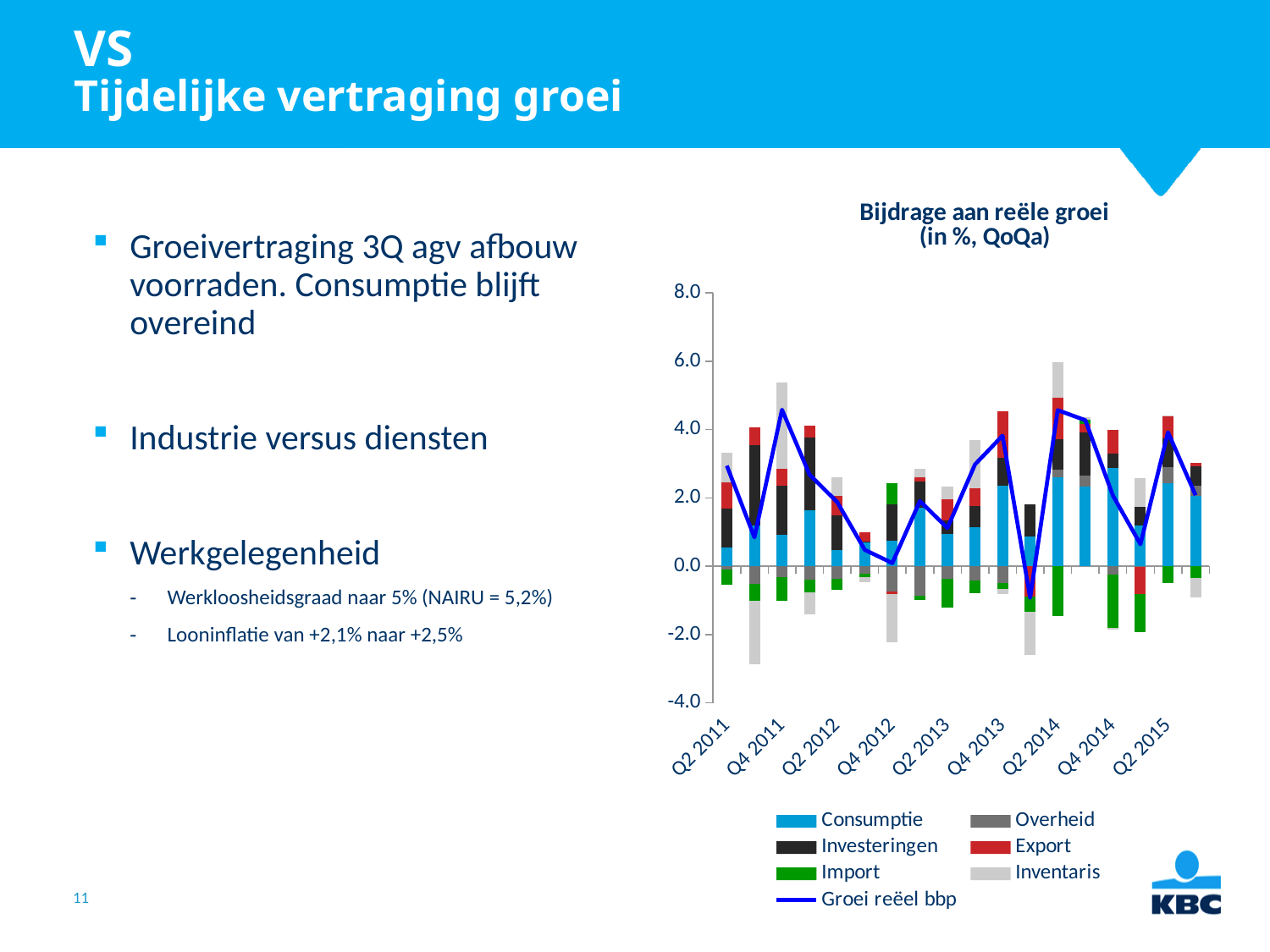
How many category labels are shown on the x axis of the chart? 9 Is the value of Groei reëel bbp at Q4 2013 greater or less than 2.0? greater What is the highest value shown on the y axis of the chart? 8.0 Is the value of Groei reëel bbp at Q2 2013 greater or less than 2.0? less What kind of chart is shown on the slide? combination bar and line chart Is the value of Groei reëel bbp at Q4 2011 greater or less than 4.0? greater What is the title of the chart? Bijdrage aan reële groei (in %, QoQa) How many series does the chart's legend list? 7 Which series in the chart is drawn as a line rather than as bars? Groei reëel bbp